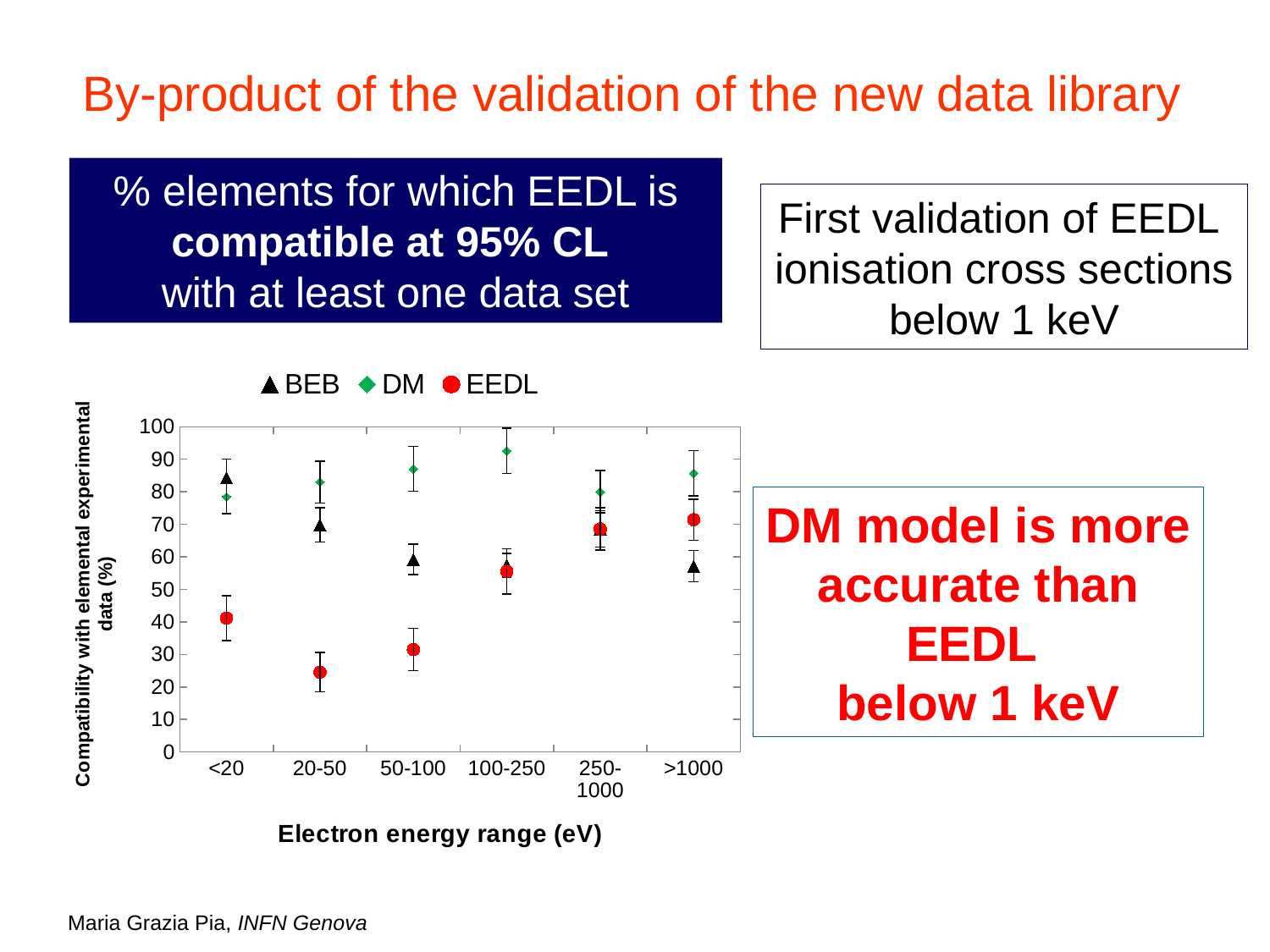
Is the BEB value for the <20 eV range greater or less than 80? greater In the >1000 eV range, which series has the larger value, EEDL or BEB? EEDL Is the EEDL value for the 20-50 eV range greater or less than 30? less What is the title of the x axis of the chart? Electron energy range (eV) In which electron energy range does the EEDL series have its lowest value? 20-50 How many electron energy range categories are shown on the x axis? 6 In which electron energy range does the BEB series have its highest value? <20 How many series does the chart legend list? 3 Is the DM value for the 100-250 eV range greater or less than 90? greater What kind of chart is shown on the slide? Scatter chart In the <20 eV range, which series has the larger value, BEB or EEDL? BEB